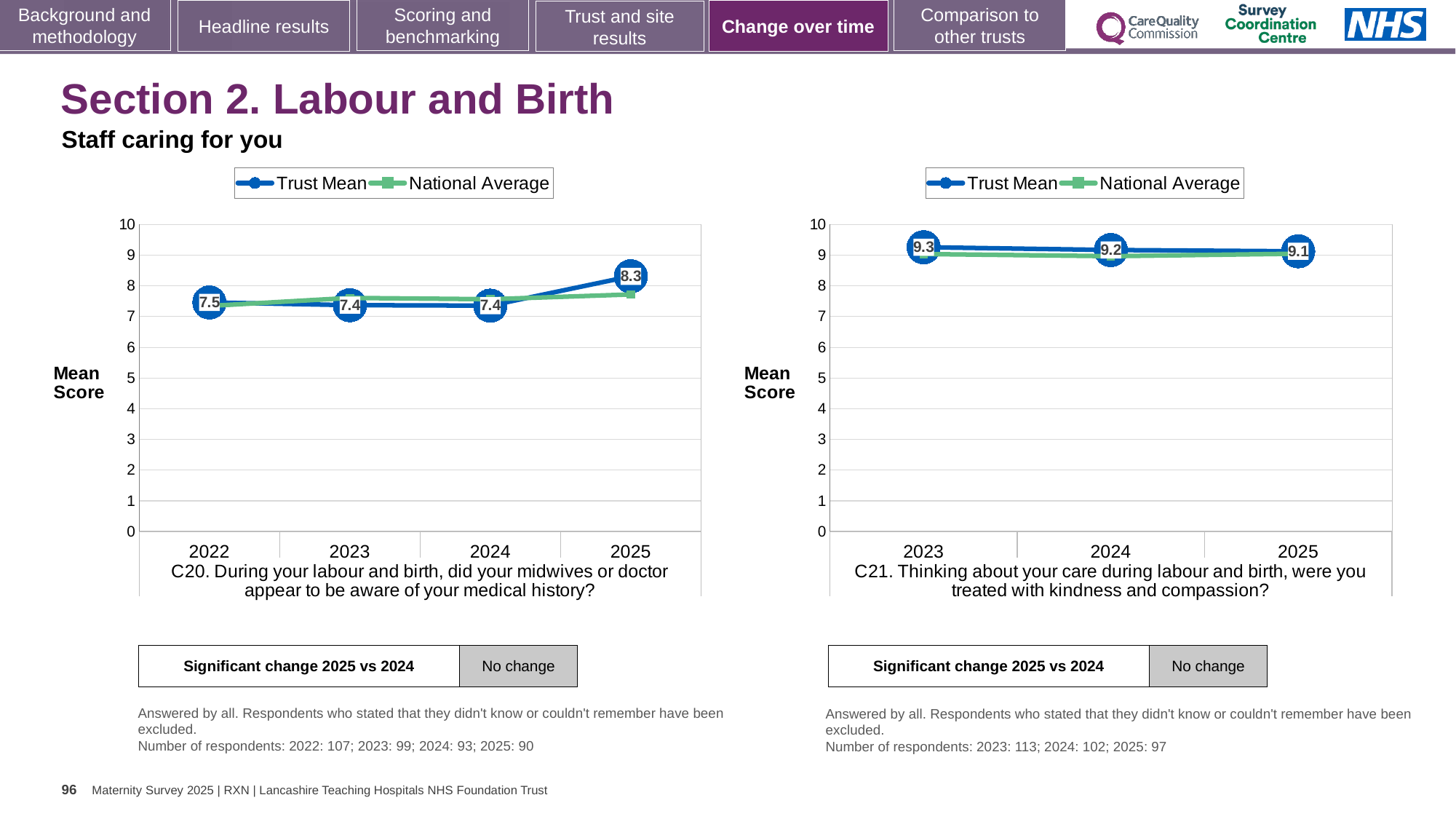
On the C20 chart (left), what is the Trust Mean for 2022? 7.5 On the C20 chart (left), how many years are shown on the x axis? 4 On the C21 chart (right), what is the Trust Mean for 2025? 9.1 On the C20 chart (left), what is the difference between the Trust Mean for 2025 and the Trust Mean for 2024? 0.9 On the C21 chart (right), what is the Trust Mean for 2023? 9.3 On the C21 chart (right), how many series does the legend list? 2 On the C20 chart (left), what is the Trust Mean for 2025? 8.3 On the C21 chart (right), which year has the lowest Trust Mean? 2025 On the C21 chart (right), what is the difference between the Trust Mean for 2023 and the Trust Mean for 2025? 0.2 What kind of chart is the C21 chart (right)? Line chart On the C20 chart (left), is the Trust Mean for 2025 greater or less than 8? greater On the C20 chart (left), which year has the highest Trust Mean? 2025